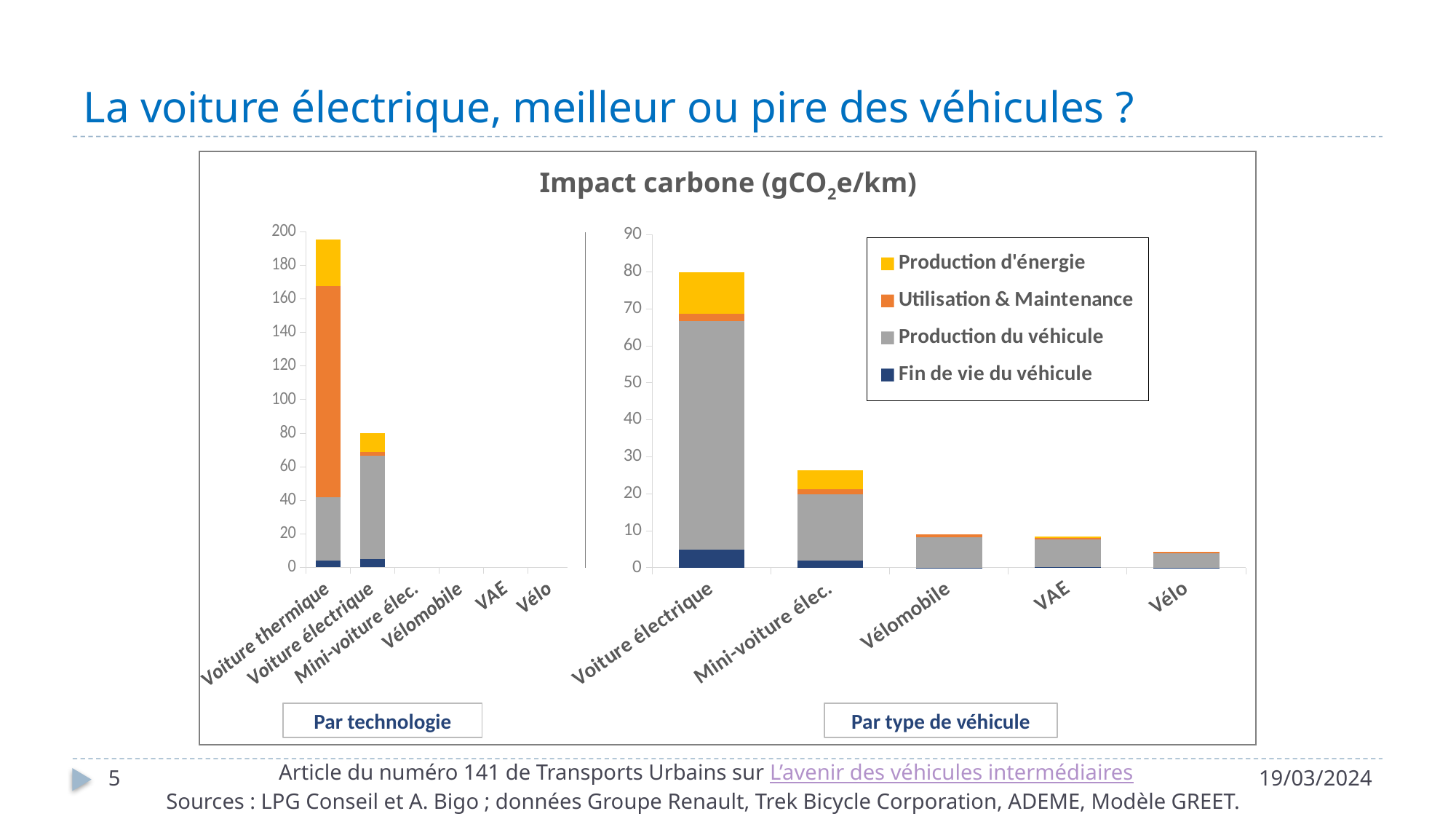
How many categories are shown on the x axis of the 'Par type de véhicule' chart on the right? 5 In the 'Par type de véhicule' chart on the right, which has the larger total: Mini-voiture élec. or Vélomobile? Mini-voiture élec. How many series does the legend list? 4 How many categories are shown on the x axis of the 'Par technologie' chart on the left? 6 In the 'Par type de véhicule' chart on the right, do the total values rise or fall from left to right along the x axis? Fall In the 'Par type de véhicule' chart on the right, is the total value for Vélo greater or less than 10? less In the 'Par type de véhicule' chart on the right, is the total value for Mini-voiture élec. greater or less than 20? greater In the 'Par technologie' chart on the left, which category has the highest total carbon impact? Voiture thermique In the 'Par technologie' chart on the left, is the total value for Voiture thermique greater or less than 180? greater In the 'Par type de véhicule' chart on the right, which category has the highest total carbon impact? Voiture électrique In the 'Par type de véhicule' chart on the right, which category has the lowest total carbon impact? Vélo What kind of chart is the 'Par technologie' chart on the left? Stacked bar chart